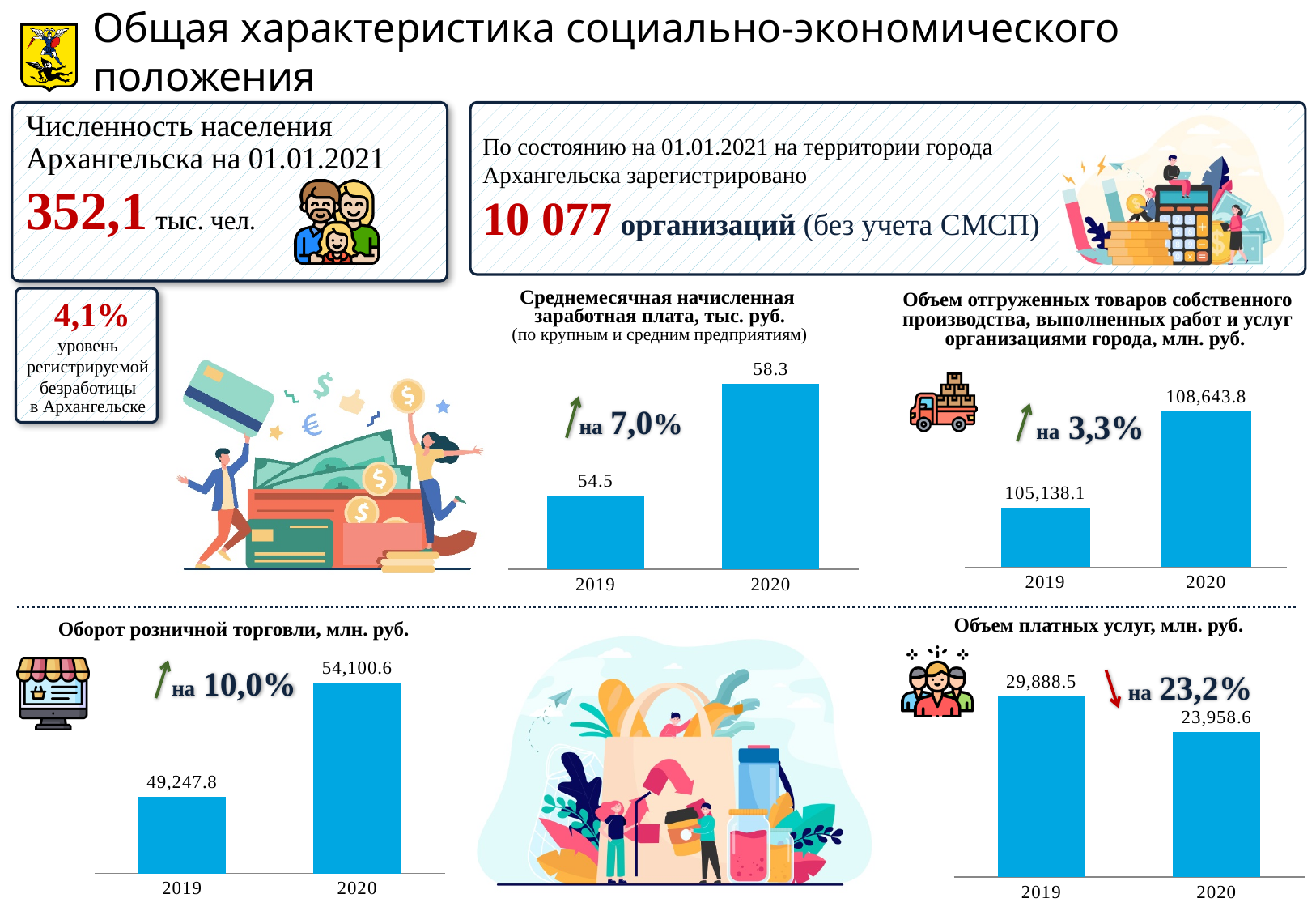
In the chart 'Объем отгруженных товаров собственного производства...', what is the value for 2019? 105,138.1 In the chart 'Среднемесячная начисленная заработная плата, тыс. руб.', what is the value for 2019? 54.5 In the chart 'Объем платных услуг, млн. руб.', which year has the lower value? 2020 In the chart 'Объем платных услуг, млн. руб.', what is the value for 2019? 29,888.5 In the chart 'Среднемесячная начисленная заработная плата, тыс. руб.', what is the value for 2020? 58.3 In the chart 'Оборот розничной торговли, млн. руб.', which year has the higher value? 2020 What type of chart is used for 'Объем отгруженных товаров собственного производства...'? bar chart In the chart 'Оборот розничной торговли, млн. руб.', what is the value for 2020? 54,100.6 In the chart 'Оборот розничной торговли, млн. руб.', what is the value for 2019? 49,247.8 In the chart 'Объем отгруженных товаров собственного производства...', what is the value for 2020? 108,643.8 In the chart 'Среднемесячная начисленная заработная плата, тыс. руб.', what is the difference between the 2020 and 2019 values? 3.8 In the chart 'Объем платных услуг, млн. руб.', do the values rise or fall from 2019 to 2020? fall